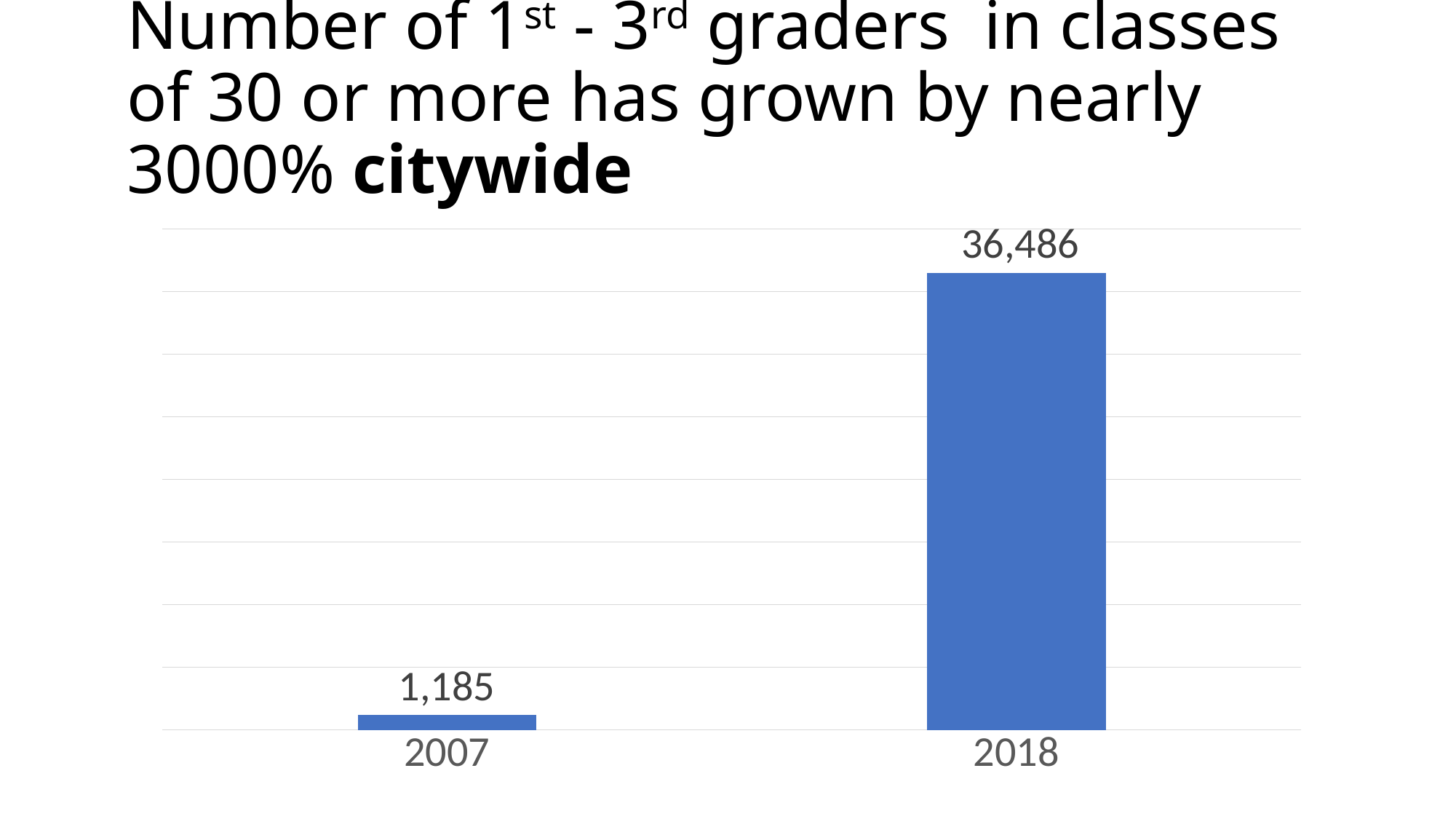
What kind of chart is shown on the slide? Bar chart Which year has the highest value? 2018 Which is larger, the value for 2007 or the value for 2018? 2018 How many years are shown on the chart? 2 What is the difference between the values for 2018 and 2007? 35,301 According to the slide title, by roughly what percentage has the number of 1st-3rd graders in classes of 30 or more grown citywide? Nearly 3000% What is the value for 2007? 1,185 What colour are the bars on the chart? Blue Which year has the lowest value? 2007 What is the value for 2018? 36,486 Do the values rise or fall from 2007 to 2018? Rise What is the total of the two values shown on the chart? 37,671